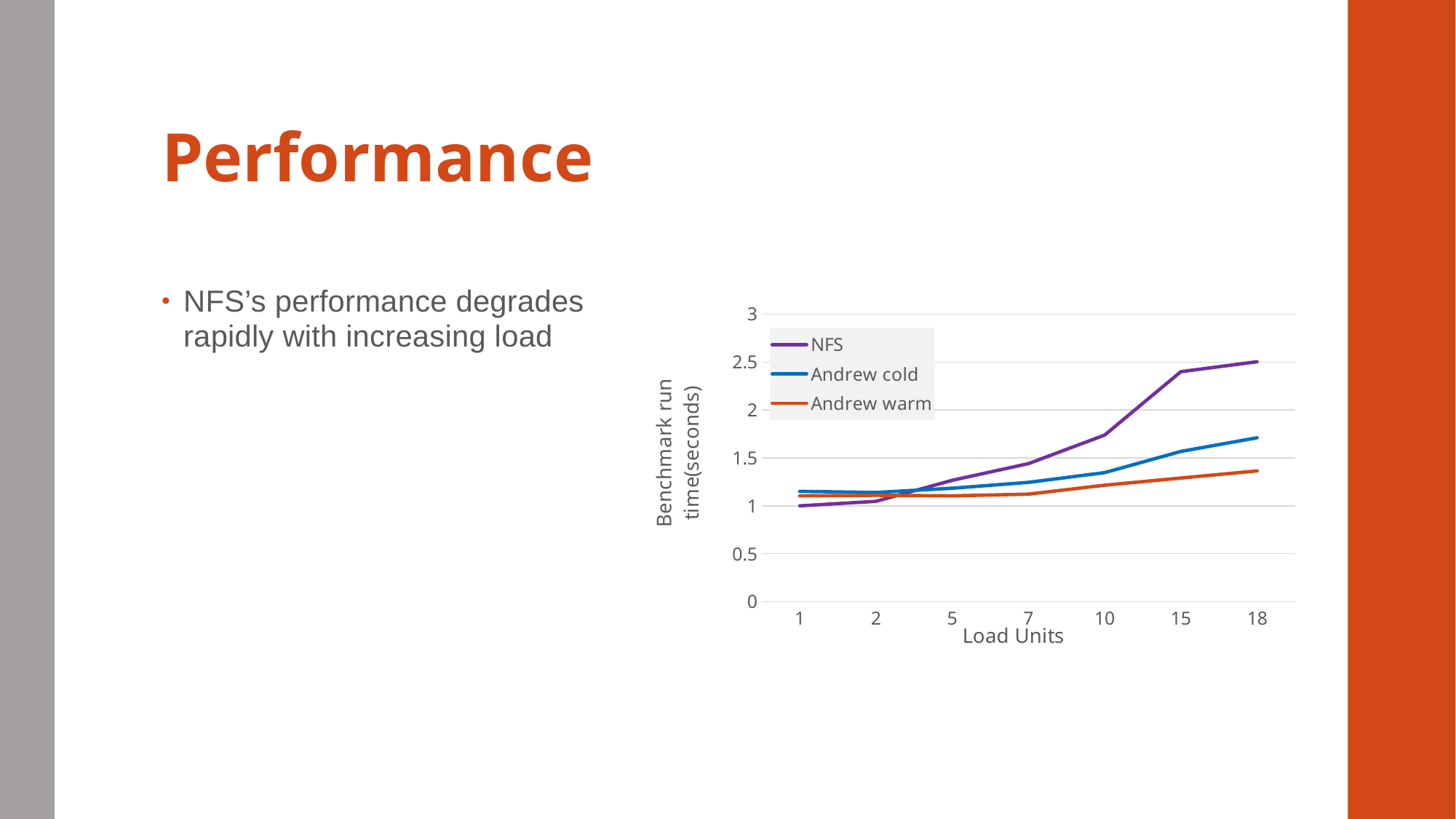
At 15 load units, which is larger: NFS or Andrew cold? NFS How many series does the chart legend list? 3 Is the Andrew warm value at 18 load units greater or less than 1.5? less Is the Andrew cold value at 18 load units greater or less than 1.5? greater Which series has the lowest benchmark run time at 18 load units? Andrew warm How many load unit values are plotted along the x axis? 7 Is the NFS value at 15 load units greater or less than 2? greater Does the NFS benchmark run time rise or fall as load units increase? rise Which series has the highest benchmark run time at 18 load units? NFS What kind of chart is shown on the slide? line chart What is the title of the x axis? Load Units What is the title of the y axis? Benchmark run time(seconds)